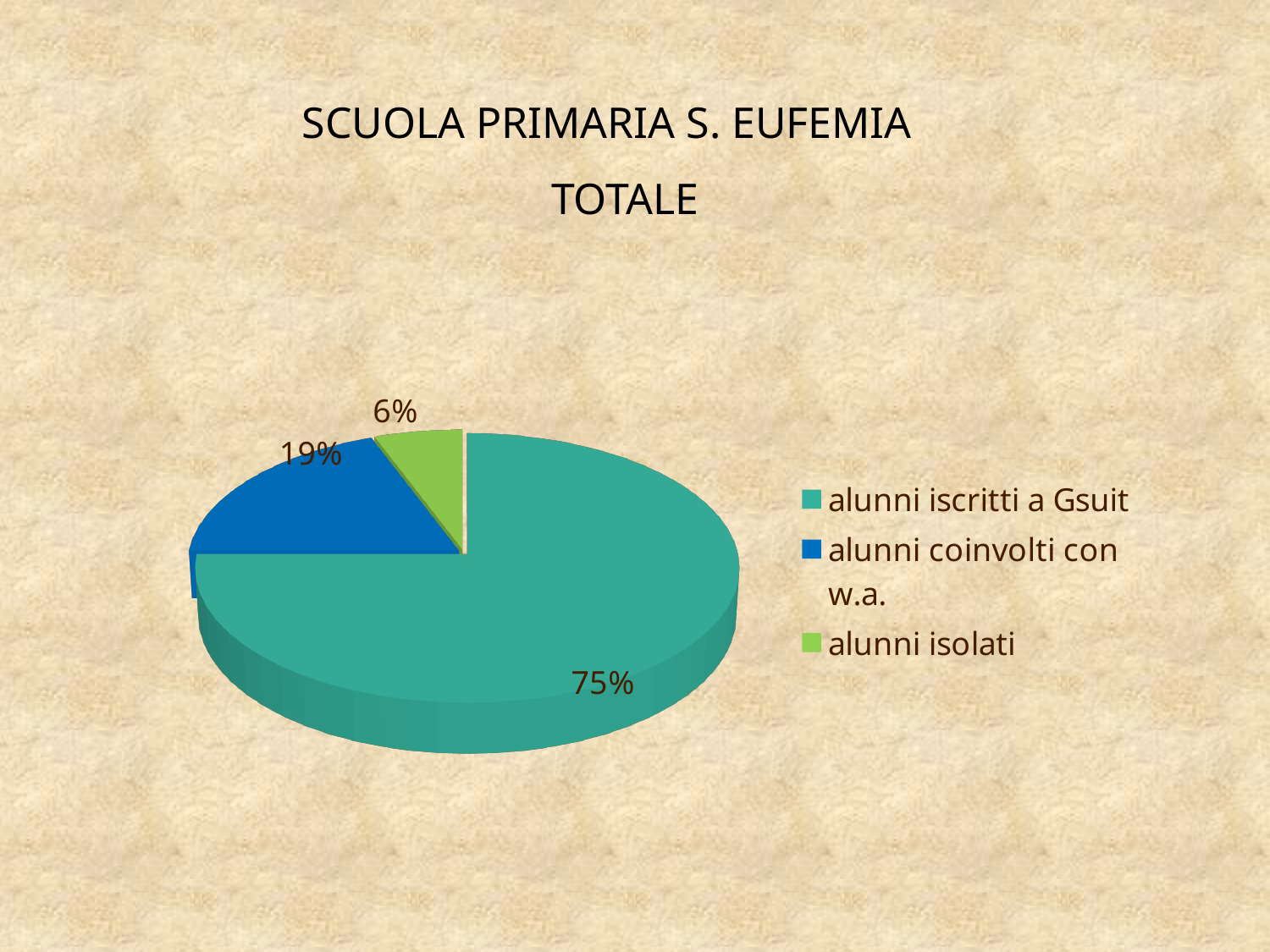
What percentage of the pie is for alunni iscritti a Gsuit? 75% Which is larger, the slice for alunni coinvolti con w.a. or the slice for alunni isolati? alunni coinvolti con w.a. What is the difference in percentage points between alunni coinvolti con w.a. and alunni isolati? 13 What percentage of the pie is for alunni coinvolti con w.a.? 19% How many slices does the pie chart have? 3 How many entries does the legend list? 3 Which category has the smallest slice of the pie? alunni isolati What is the difference in percentage points between alunni iscritti a Gsuit and alunni coinvolti con w.a.? 56 Which category has the largest slice of the pie? alunni iscritti a Gsuit What kind of chart is shown on the slide? pie chart What is the title of the chart? SCUOLA PRIMARIA S. EUFEMIA TOTALE What percentage of the pie is for alunni isolati? 6%